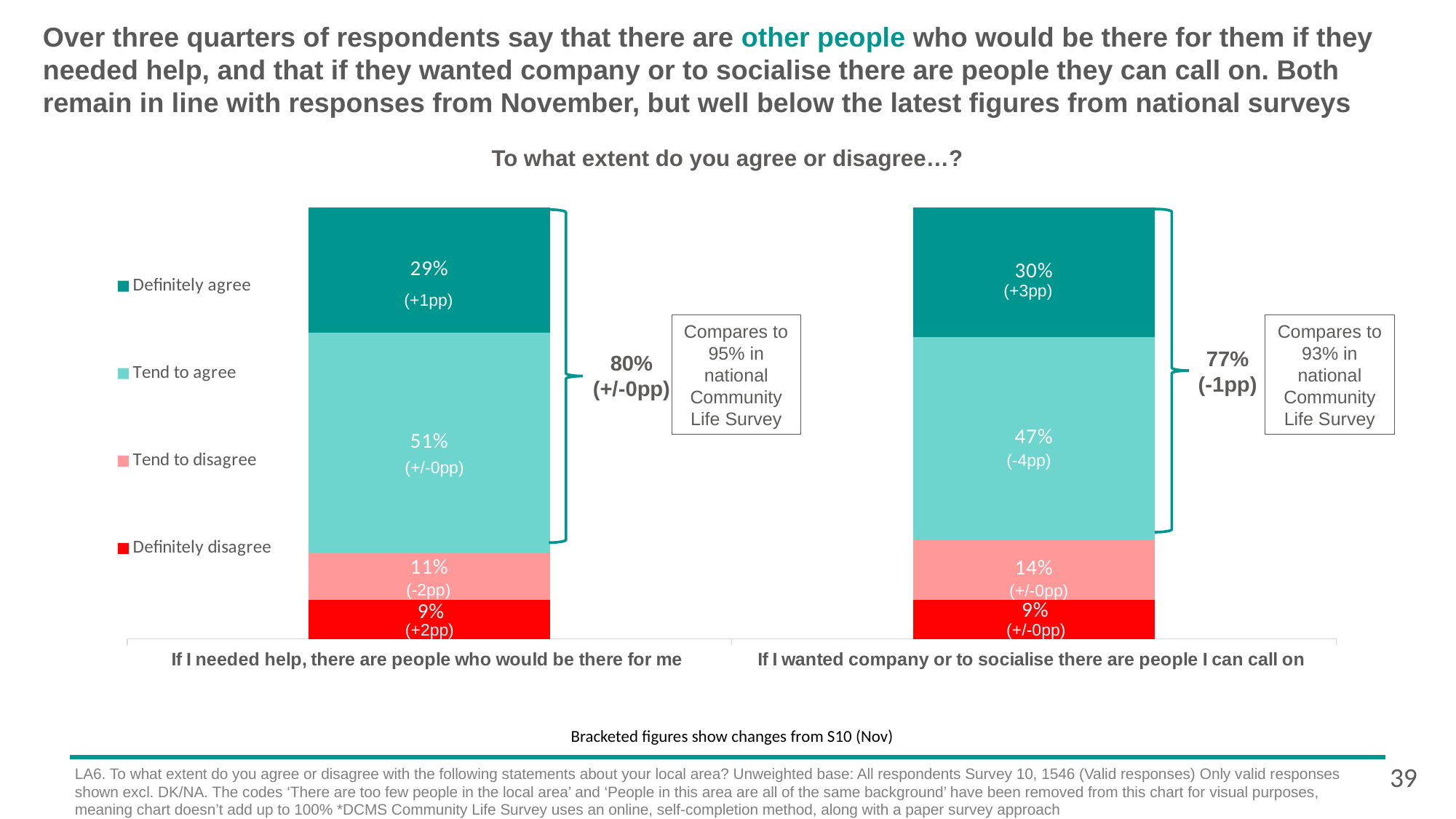
What percentage of respondents 'Tend to disagree' with 'If I wanted company or to socialise there are people I can call on'? 14% What is the change from November shown for 'Tend to agree' in the 'If I wanted company or to socialise there are people I can call on' bar? -4pp How many series does the legend list? 4 What is the title of the chart? To what extent do you agree or disagree…? Which response category is the largest segment in the bar for 'If I needed help, there are people who would be there for me'? Tend to agree What is the combined percentage of 'Definitely agree' and 'Tend to agree' for 'If I needed help, there are people who would be there for me'? 80% How many statements (bars) are plotted in the chart? 2 Which statement has the larger 'Definitely agree' percentage? If I wanted company or to socialise there are people I can call on What is the difference in the 'Tend to agree' percentage between 'If I needed help, there are people who would be there for me' and 'If I wanted company or to socialise there are people I can call on'? 4 percentage points What kind of chart is shown on the slide? Stacked bar chart What percentage of respondents 'Tend to agree' with 'If I needed help, there are people who would be there for me'? 51% What percentage of respondents 'Definitely agree' with 'If I wanted company or to socialise there are people I can call on'? 30%